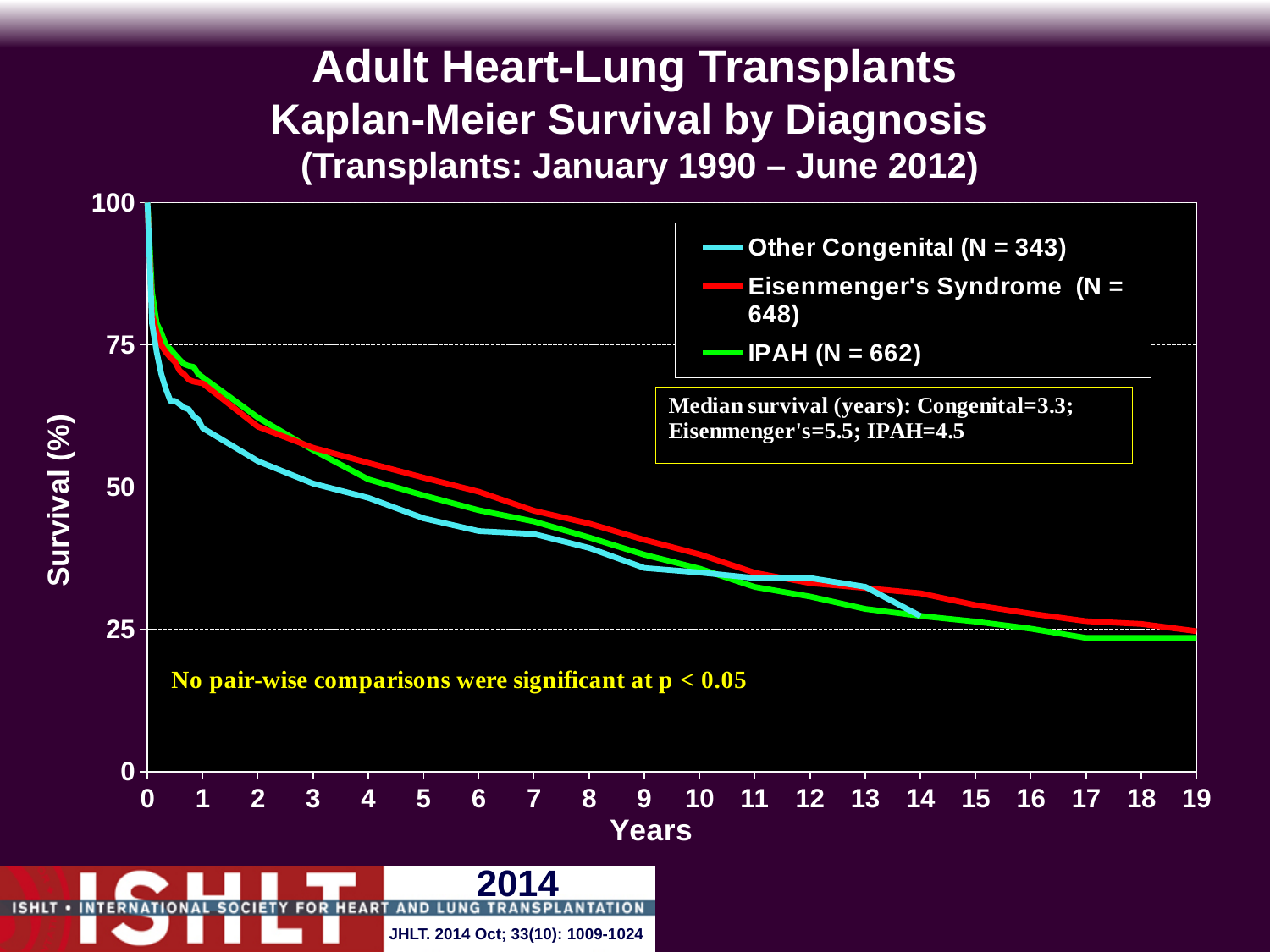
What is the median survival in years for IPAH? 4.5 What is the difference in median survival (years) between Eisenmenger's and Congenital? 2.2 What is the N for the Other Congenital group? 343 Which diagnosis group has the highest median survival? Eisenmenger's Syndrome Which group has the largest N in the legend? IPAH (N = 662) What is the median survival in years for Eisenmenger's Syndrome? 5.5 What kind of chart is shown on the slide? line chart Which diagnosis group has the lowest median survival? Congenital At 5 years, is the survival for Other Congenital greater or less than 50? less How many series does the legend list? 3 Do the survival curves rise or fall as years increase? fall At 5 years, which curve is higher, Other Congenital or Eisenmenger's Syndrome? Eisenmenger's Syndrome